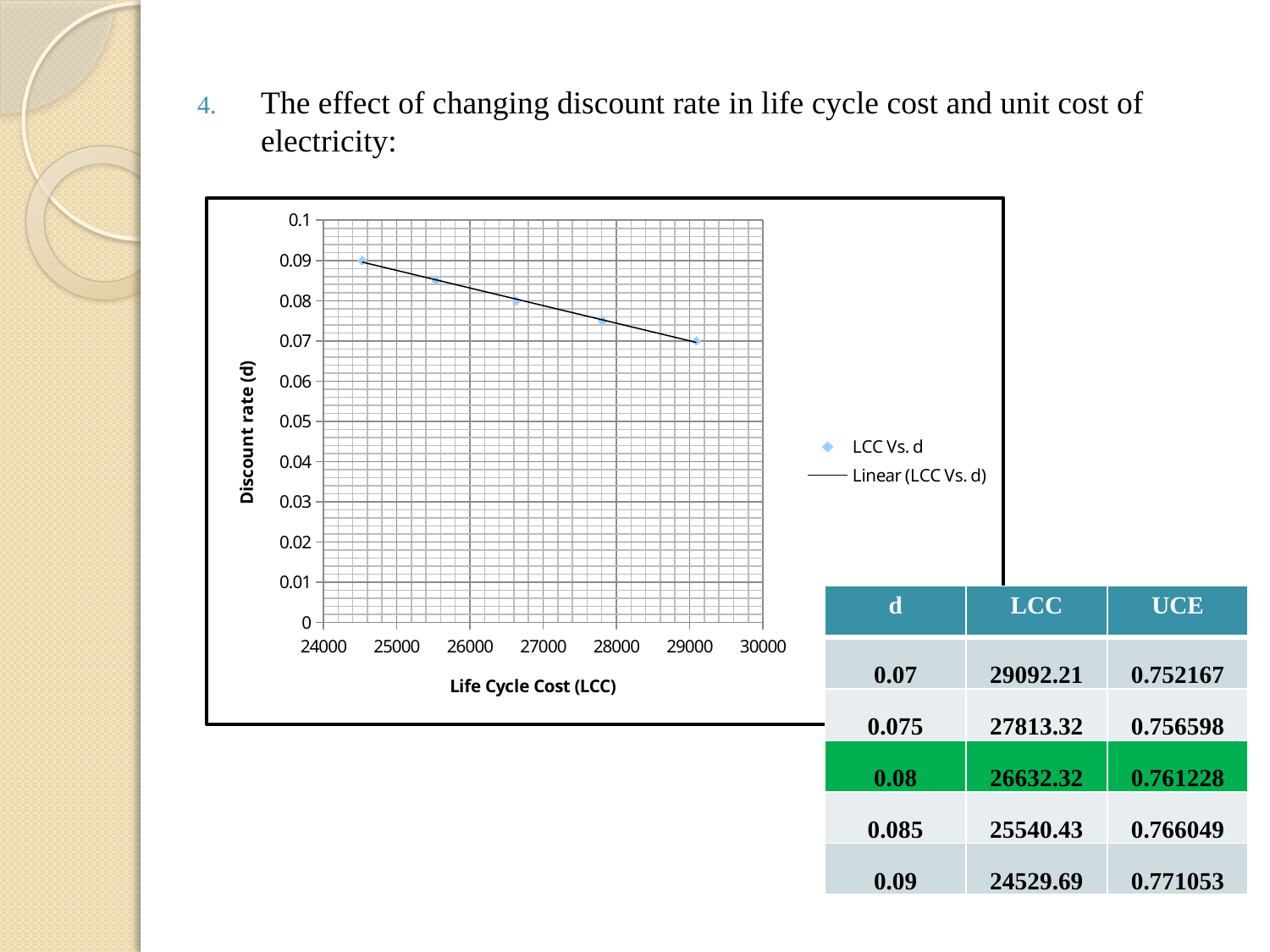
What kind of chart is shown on the slide? Scatter chart What is the title of the x axis of the chart? Life Cycle Cost (LCC) Is the discount rate for the point with the lowest Life Cycle Cost greater or less than 0.08? greater How many entries does the legend of the chart list? 2 As Life Cycle Cost increases along the x axis, does the discount rate rise or fall? Fall What is the highest discount rate (d) plotted in the chart? 0.09 Is the discount rate for the point with the highest Life Cycle Cost greater or less than 0.08? less How many data points are plotted in the LCC Vs. d chart? 5 According to the table beside the chart, what is the LCC value at a discount rate of 0.08? 26632.32 What is the title of the y axis of the chart? Discount rate (d) What is the lowest discount rate (d) plotted in the chart? 0.07 According to the table beside the chart, which discount rate has the larger LCC, 0.07 or 0.09? 0.07